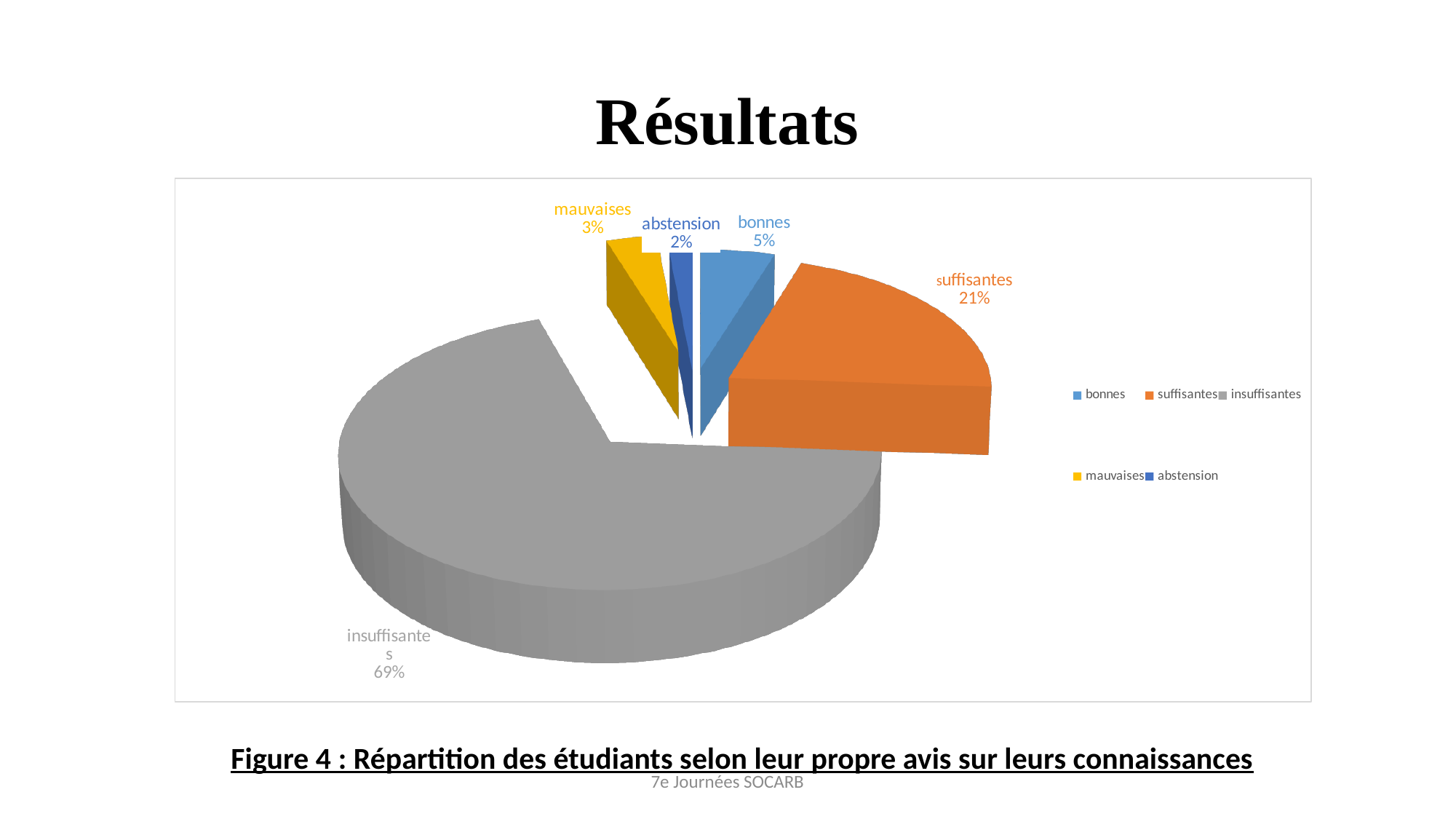
What share of the pie does the 'insuffisantes' slice represent? 69% Which category has the largest slice of the pie? insuffisantes How many categories are shown in the pie chart? 5 What is the difference in percentage points between 'insuffisantes' and 'suffisantes'? 48 What kind of chart is shown on the slide? pie chart What colour is the 'suffisantes' slice? orange What is the value shown for 'bonnes'? 5% What is the value shown for 'mauvaises'? 3% Which category has the smallest slice of the pie? abstension What is the value shown for 'abstension'? 2% Which is larger, the 'bonnes' slice or the 'mauvaises' slice? bonnes What share of the pie does the 'suffisantes' slice represent? 21%